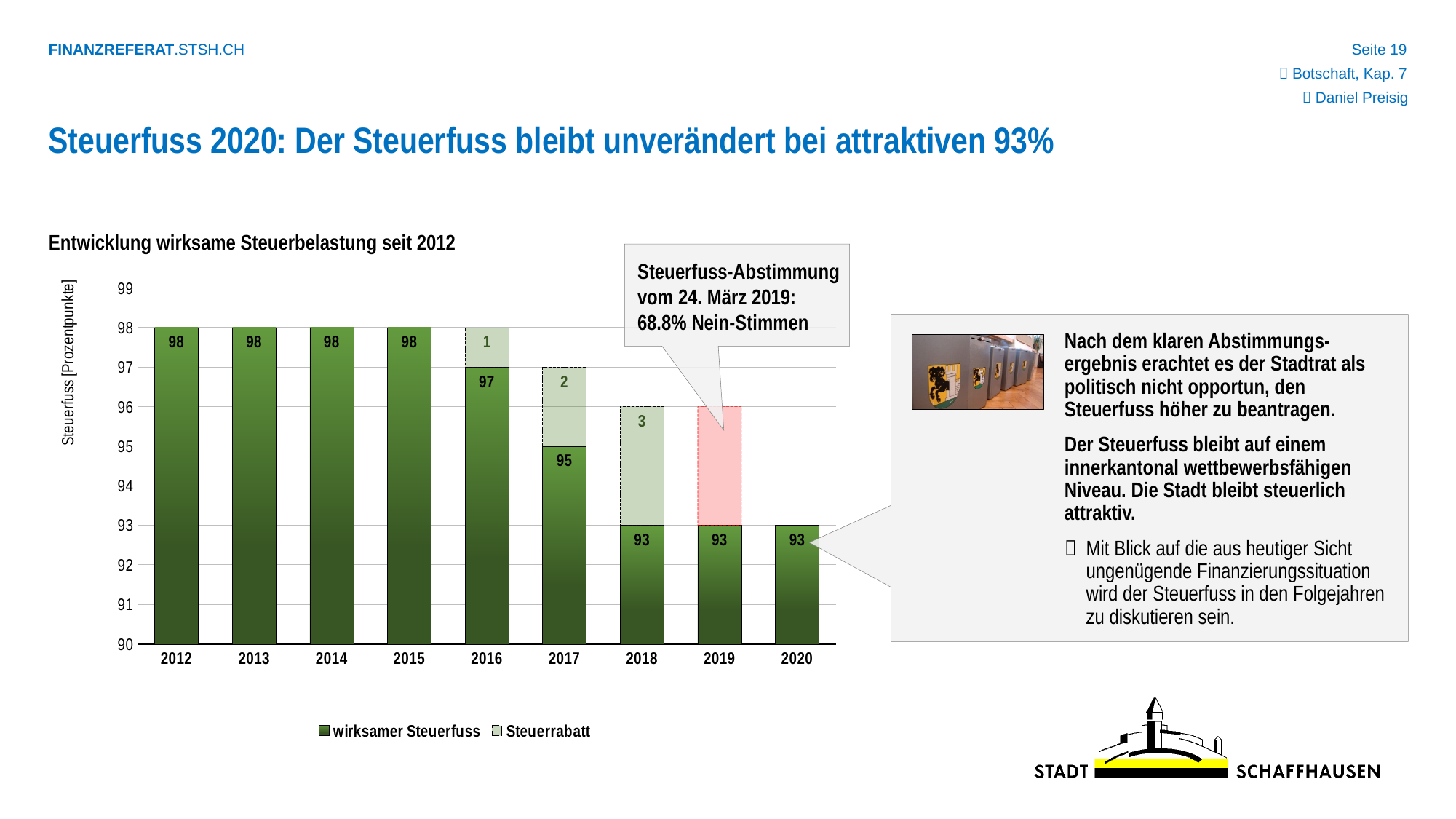
Which year has the lowest Steuerrabatt among the years where a Steuerrabatt is labelled? 2016 What is the total height of the stacked bar for 2017 (wirksamer Steuerfuss plus Steuerrabatt)? 97 Does the wirksamer Steuerfuss rise or fall from 2012 to 2020? Fall How many series does the legend list? 2 What kind of chart is shown on the slide? Stacked bar chart What is the title of the chart? Entwicklung wirksame Steuerbelastung seit 2012 What is the Steuerrabatt value shown for 2018? 3 What is the difference between the wirksamer Steuerfuss in 2012 and in 2020? 5 How many years are shown on the x axis of the chart? 9 What is the value of wirksamer Steuerfuss for 2017? 95 What is the value of wirksamer Steuerfuss for 2020? 93 Which is larger, the wirksamer Steuerfuss in 2016 or in 2018? 2016